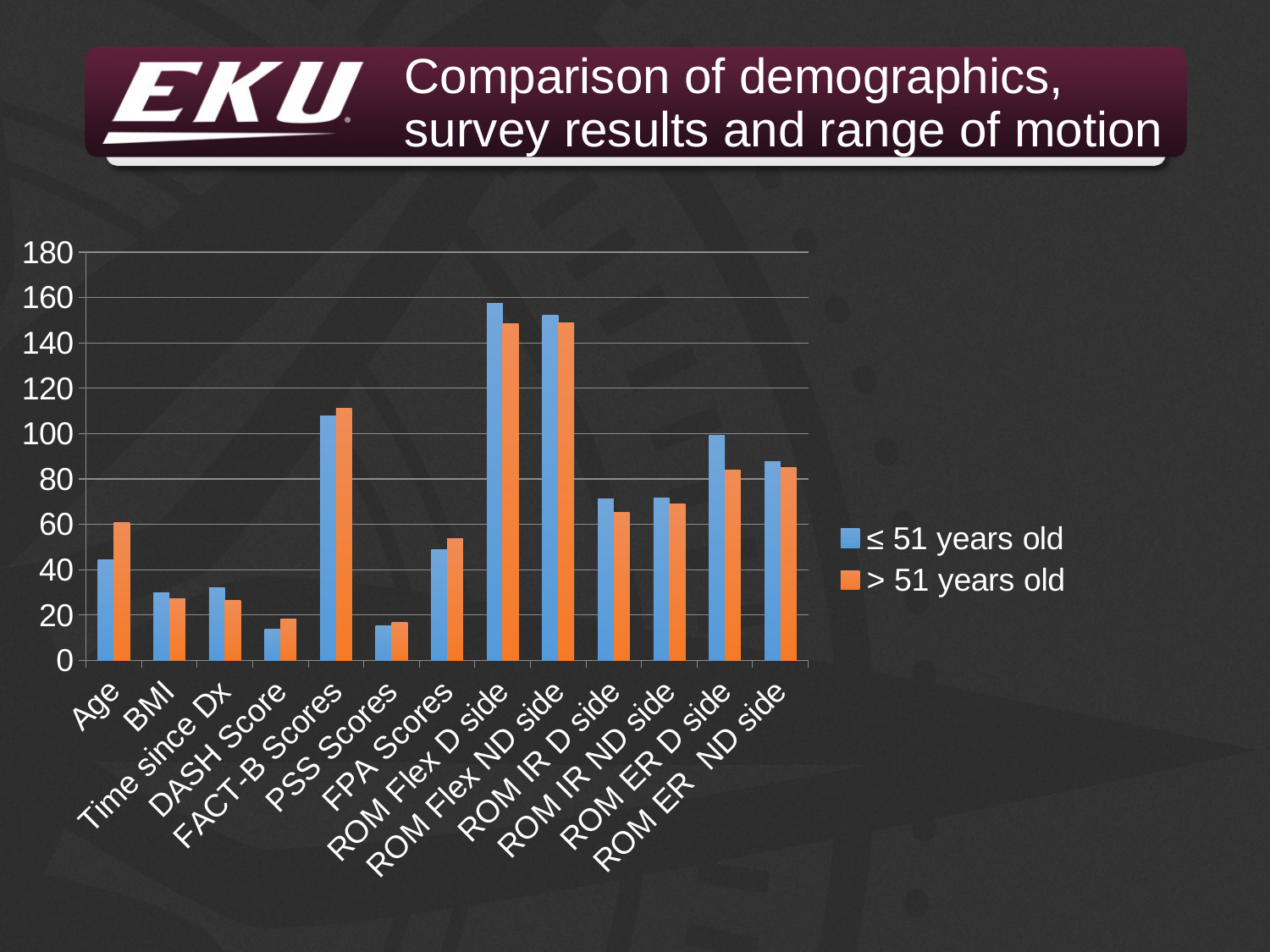
For Age, which series has the larger value, ≤ 51 years old or > 51 years old? > 51 years old Is the ≤ 51 years old value for ROM IR D side greater or less than 80? less How many categories are shown on the x axis? 13 Is the > 51 years old value for ROM ER D side greater or less than 100? less How many series does the legend list? 2 Which category has the highest value for the ≤ 51 years old series? ROM Flex D side Is the ≤ 51 years old value for ROM Flex D side greater or less than 140? greater For ROM ER D side, which series has the larger value, ≤ 51 years old or > 51 years old? ≤ 51 years old What is the title of the slide containing the chart? Comparison of demographics, survey results and range of motion What kind of chart is shown on the slide? bar chart